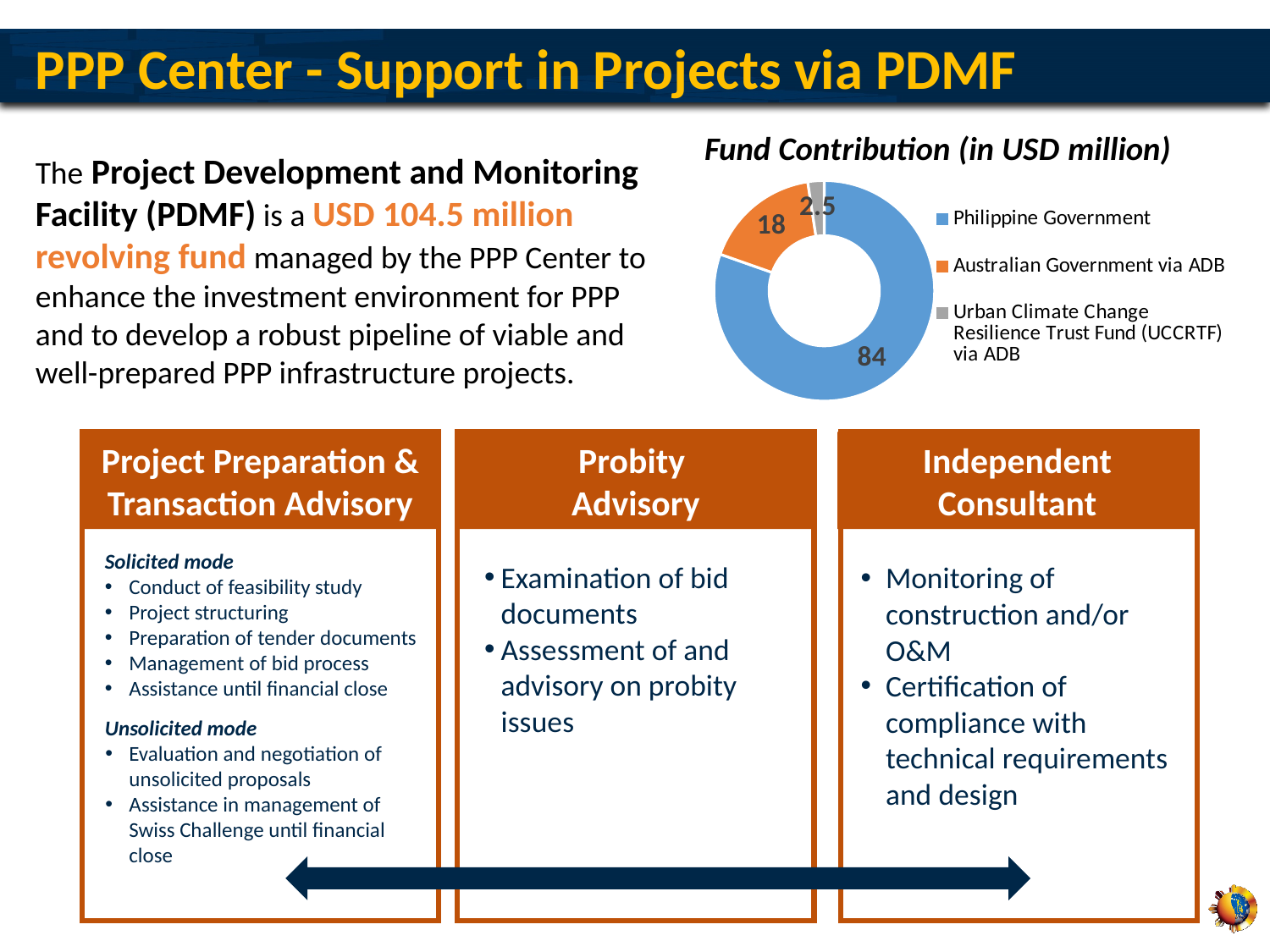
Which is larger: the contribution from the Australian Government via ADB or from the UCCRTF via ADB? Australian Government via ADB What type of chart is used to show the Fund Contribution? Doughnut (pie) chart Which contributor has the smallest share in the Fund Contribution chart? Urban Climate Change Resilience Trust Fund (UCCRTF) via ADB What is the title of the chart on the slide? Fund Contribution (in USD million) What is the fund contribution of the Urban Climate Change Resilience Trust Fund (UCCRTF) via ADB? 2.5 How much larger is the Philippine Government contribution than the Australian Government via ADB contribution, in USD million? 66 How many contributors are shown in the Fund Contribution chart? 3 What is the total of all contributions shown in the Fund Contribution chart, in USD million? 104.5 What is the fund contribution of the Australian Government via ADB? 18 What is the difference between the Australian Government via ADB contribution and the UCCRTF via ADB contribution, in USD million? 15.5 What is the fund contribution of the Philippine Government in the Fund Contribution chart? 84 Which contributor has the largest share in the Fund Contribution chart? Philippine Government